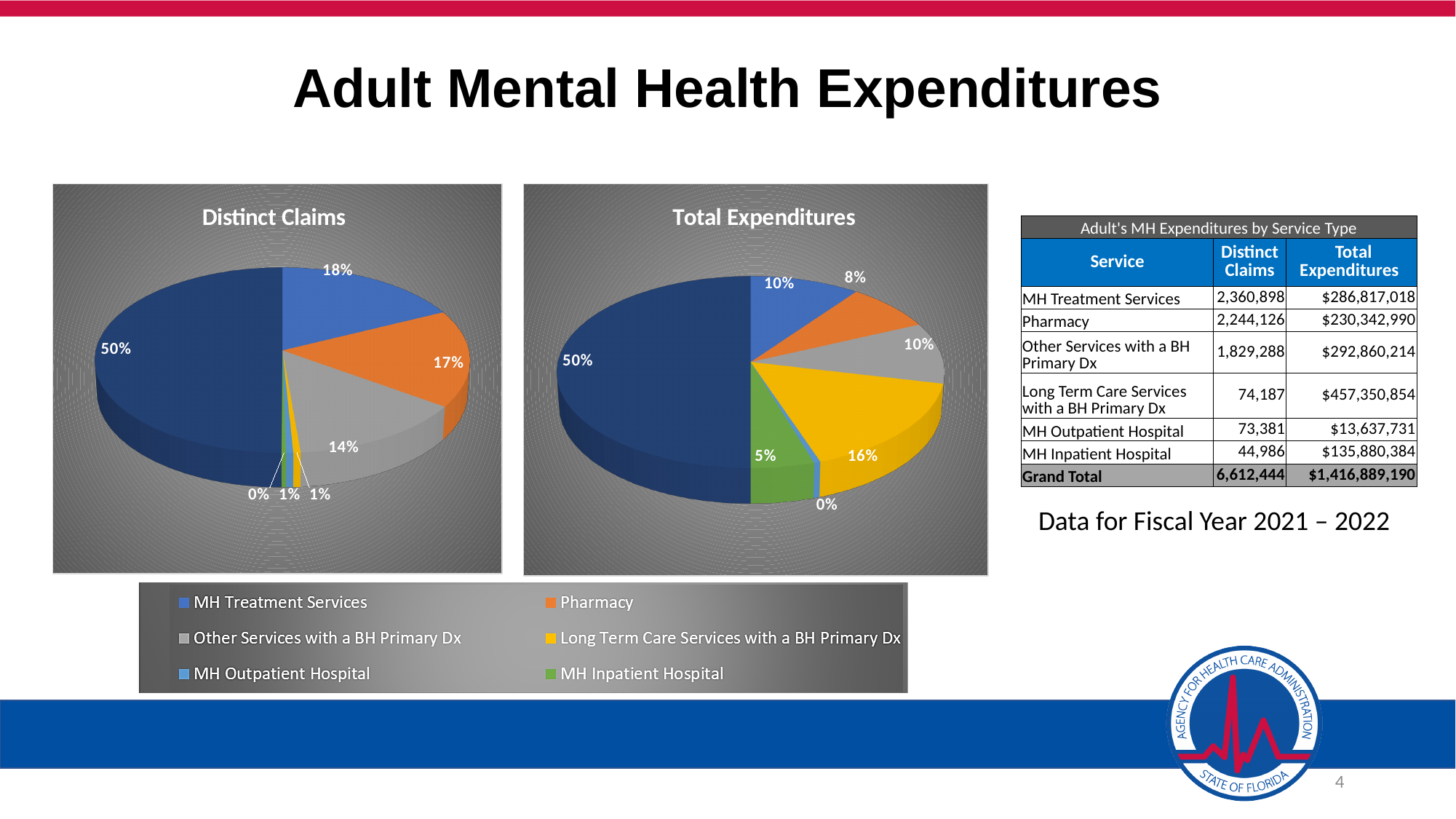
In the Total Expenditures chart, what percentage is shown for MH Treatment Services? 10% In the Total Expenditures chart, what percentage is shown for Long Term Care Services with a BH Primary Dx? 16% What kind of chart is the Total Expenditures chart? Pie chart How many entries does the shared legend below the charts list? 6 In the Total Expenditures chart, what percentage is shown for MH Inpatient Hospital? 5% In the Distinct Claims chart, what is the difference between the MH Treatment Services share and the Pharmacy share? 1% In the Total Expenditures chart, what percentage is shown for Pharmacy? 8% In the Distinct Claims chart, which is larger: the share for Pharmacy or the share for Other Services with a BH Primary Dx? Pharmacy In the Distinct Claims chart, what percentage is shown for Other Services with a BH Primary Dx? 14% In the Distinct Claims chart, what percentage is shown for MH Treatment Services? 18% In the Distinct Claims chart, what percentage is shown for Pharmacy? 17% In the Total Expenditures chart, which is larger: the share for Long Term Care Services with a BH Primary Dx or the share for MH Inpatient Hospital? Long Term Care Services with a BH Primary Dx